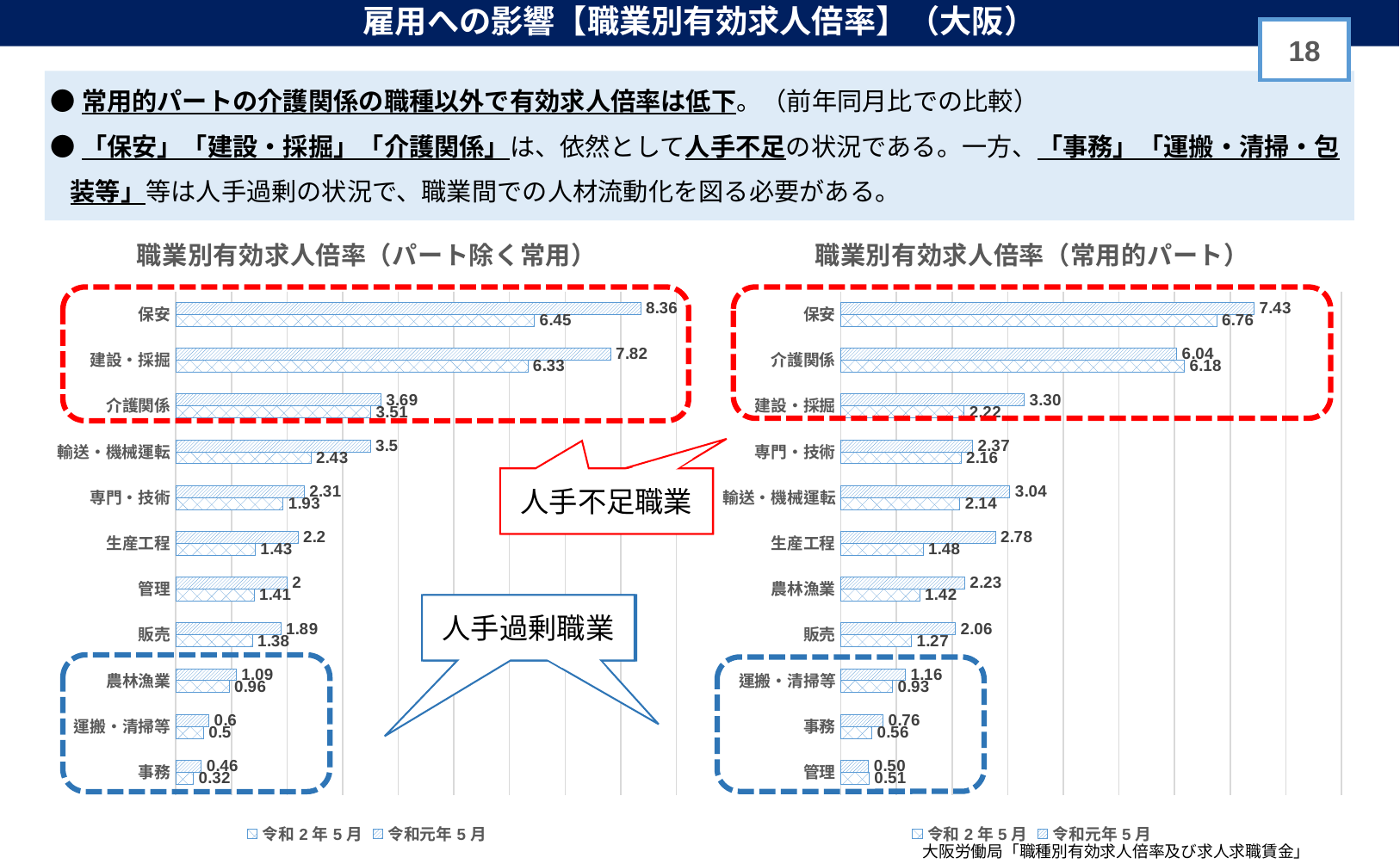
How many occupation categories are shown in the left chart 職業別有効求人倍率（パート除く常用）? 11 In the left chart 職業別有効求人倍率（パート除く常用）, what is the value shown on the upper bar for 保安? 8.36 In the right chart 職業別有効求人倍率（常用的パート）, which is larger: the upper bar for 建設・採掘 or the upper bar for 輸送・機械運転? 建設・採掘 In the right chart 職業別有効求人倍率（常用的パート）, which occupation has the lowest values? 管理 What type of chart is used on this slide for 職業別有効求人倍率（パート除く常用）? bar chart In the left chart 職業別有効求人倍率（パート除く常用）, what is the difference between the two values shown for 保安 (8.36 and 6.45)? 1.91 In the left chart 職業別有効求人倍率（パート除く常用）, which occupation has the highest value? 保安 What are the two legend entries shown under the left chart 職業別有効求人倍率（パート除く常用）? 令和２年５月 and 令和元年５月 In the left chart 職業別有効求人倍率（パート除く常用）, what is the value shown on the lower bar for 事務? 0.32 In the right chart 職業別有効求人倍率（常用的パート）, what is the value shown on the lower bar for 管理? 0.51 In the right chart 職業別有効求人倍率（常用的パート）, what is the value shown on the upper bar for 介護関係? 6.04 How many series does the legend of the right chart 職業別有効求人倍率（常用的パート） list? 2